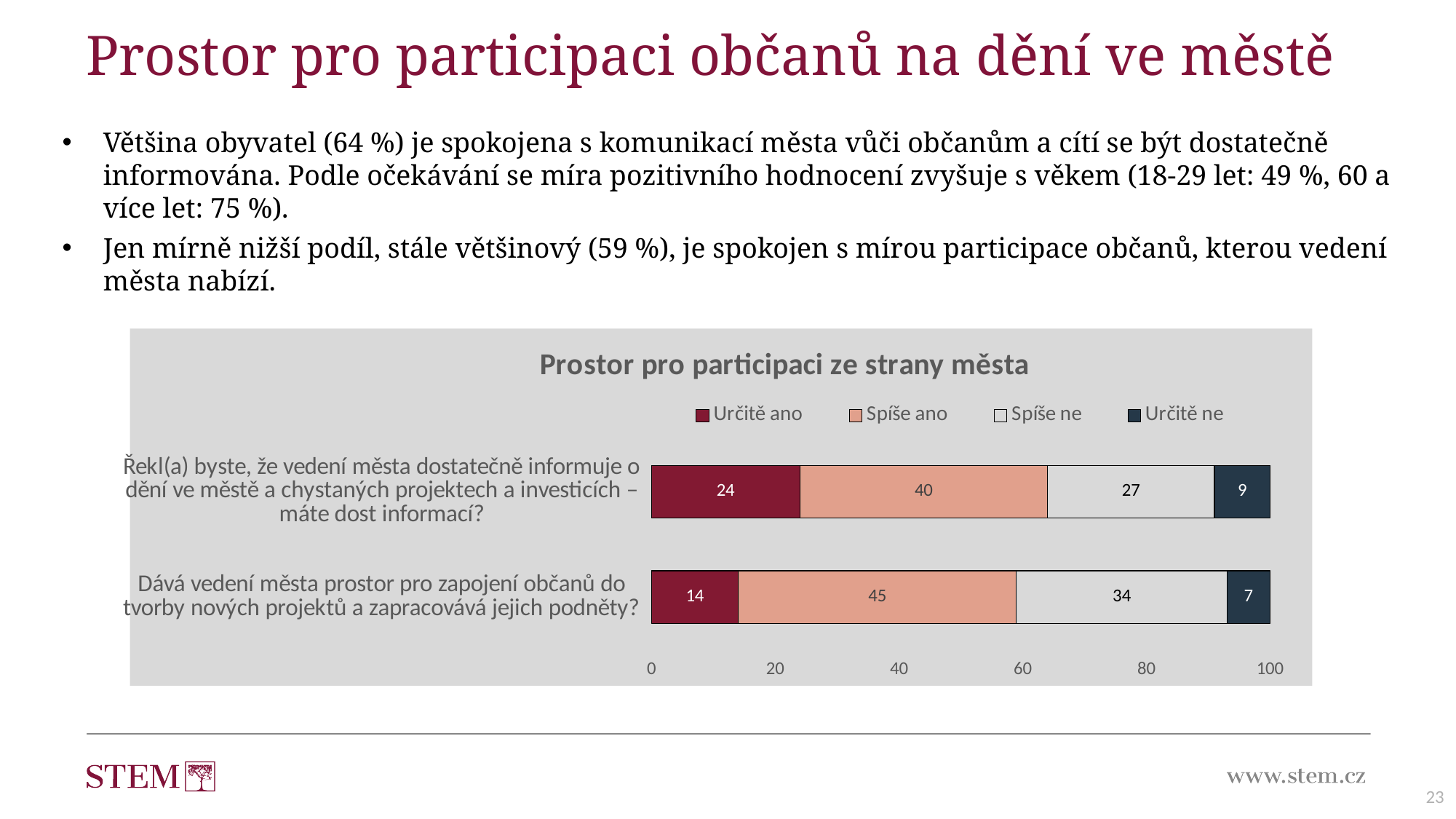
What is the 'Určitě ne' value for the question about whether the city leadership sufficiently informs about events in the city? 9 What is the 'Spíše ano' value for the question about whether the city leadership gives space for citizen involvement in new projects? 45 What is the 'Určitě ano' value for the question about whether the city leadership sufficiently informs about events in the city (máte dost informací)? 24 What is the difference between the 'Spíše ne' values of the two questions? 7 What is the title of the chart? Prostor pro participaci ze strany města Which of the two questions has the higher 'Určitě ano' value? Řekl(a) byste, že vedení města dostatečně informuje o dění ve městě a chystaných projektech a investicích – máte dost informací? How many series does the legend list? 4 What is the 'Spíše ne' value for the question about space for citizen involvement in new projects? 34 How many bars (questions) are plotted in the chart? 2 Which legend entry is shown in dark red? Určitě ano What kind of chart is shown on the slide? stacked bar chart What is the combined 'Určitě ano' and 'Spíše ano' share for the question about whether the city leadership sufficiently informs about events in the city? 64